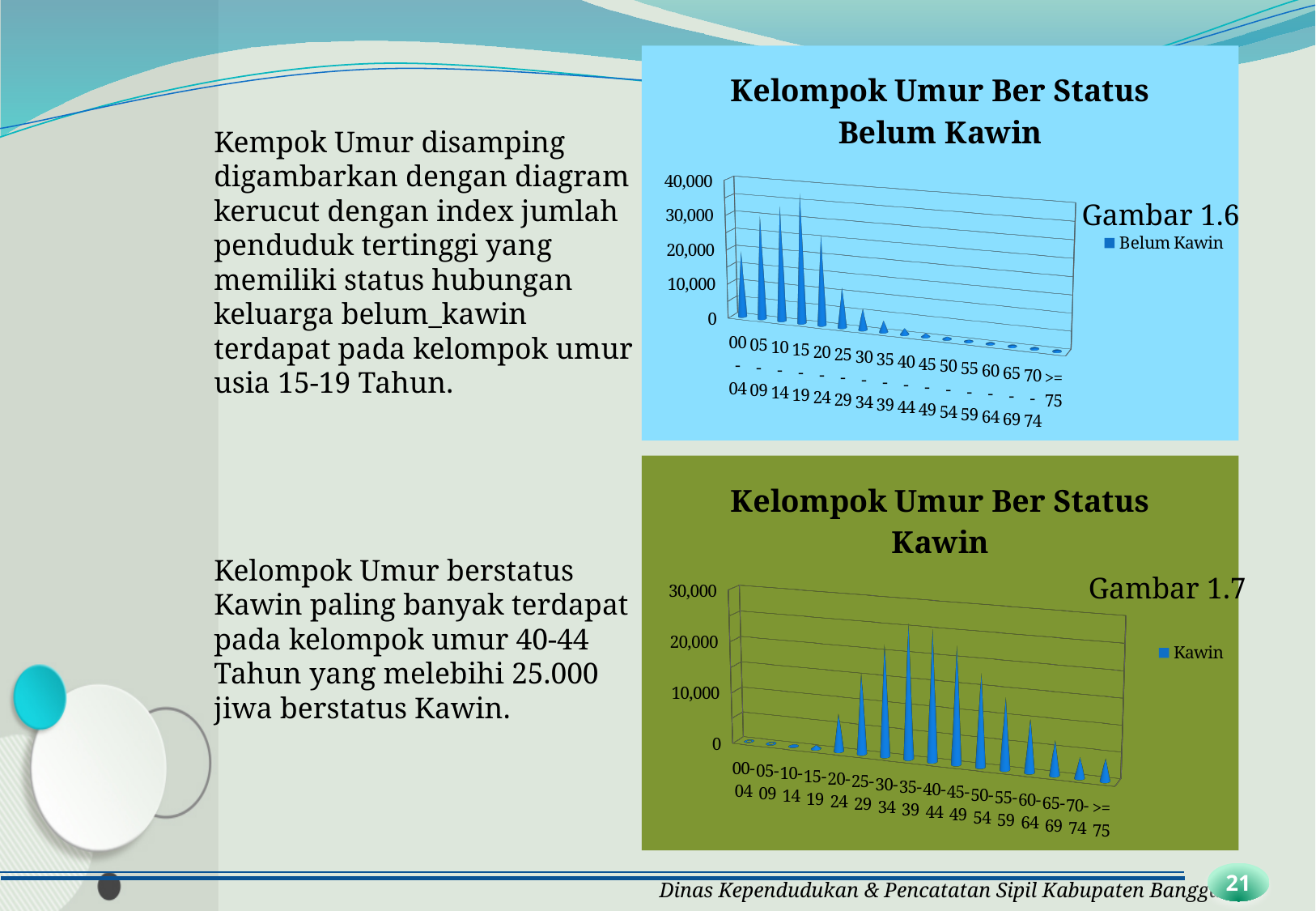
How many series does the legend of the 'Kelompok Umur Ber Status Kawin' chart list? 1 In the 'Kelompok Umur Ber Status Kawin' chart, which is larger: the value for 40-44 or the value for 00-04? 40-44 In the 'Kelompok Umur Ber Status Belum Kawin' chart, how many age-group categories are shown on the x axis? 16 In the 'Kelompok Umur Ber Status Belum Kawin' chart, which age group has the highest value? 15-19 In the 'Kelompok Umur Ber Status Belum Kawin' chart, is the value for the 40-44 age group greater or less than 10,000? less What type of chart is the 'Kelompok Umur Ber Status Belum Kawin' chart? bar chart In the 'Kelompok Umur Ber Status Belum Kawin' chart, is the value for the 15-19 age group greater or less than 30,000? greater In the 'Kelompok Umur Ber Status Kawin' chart, which age group has the highest value? 35-39 In the 'Kelompok Umur Ber Status Kawin' chart, is the value for the 40-44 age group greater or less than 20,000? greater What is the legend entry shown on the 'Kelompok Umur Ber Status Belum Kawin' chart? Belum Kawin In the 'Kelompok Umur Ber Status Belum Kawin' chart, do the values generally rise or fall from the 15-19 age group towards the >=75 age group? fall